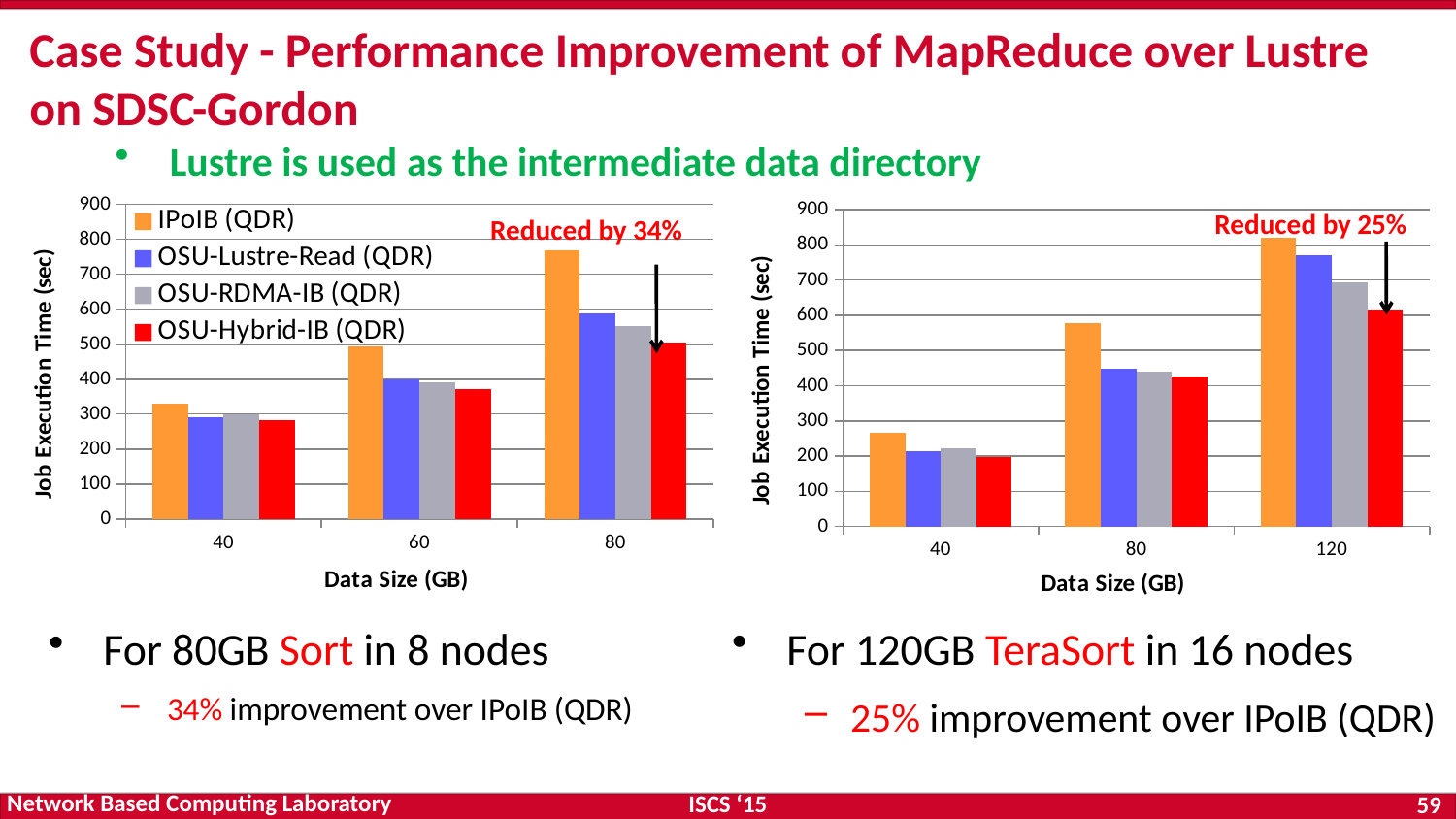
How many data size categories are shown on the x axis of the right chart? 3 In the right chart, is the value for IPoIB (QDR) at 120 GB greater or less than 800? greater In the left chart, which is larger at 60 GB: IPoIB (QDR) or OSU-Lustre-Read (QDR)? IPoIB (QDR) In the left chart, which series has the highest job execution time at 80 GB? IPoIB (QDR) In the right chart, which series has the lowest job execution time at 120 GB? OSU-Hybrid-IB (QDR) How many series does the legend on the left chart list? 4 In the left chart, is the value for IPoIB (QDR) at 80 GB greater or less than 700? greater What kind of chart is the left chart on the slide? bar chart In the right chart, is the value for OSU-Hybrid-IB (QDR) at 40 GB greater or less than 300? less In the right chart, does the job execution time for IPoIB (QDR) rise or fall as data size increases from 40 GB to 120 GB? rise What is the y-axis label of the left chart? Job Execution Time (sec)